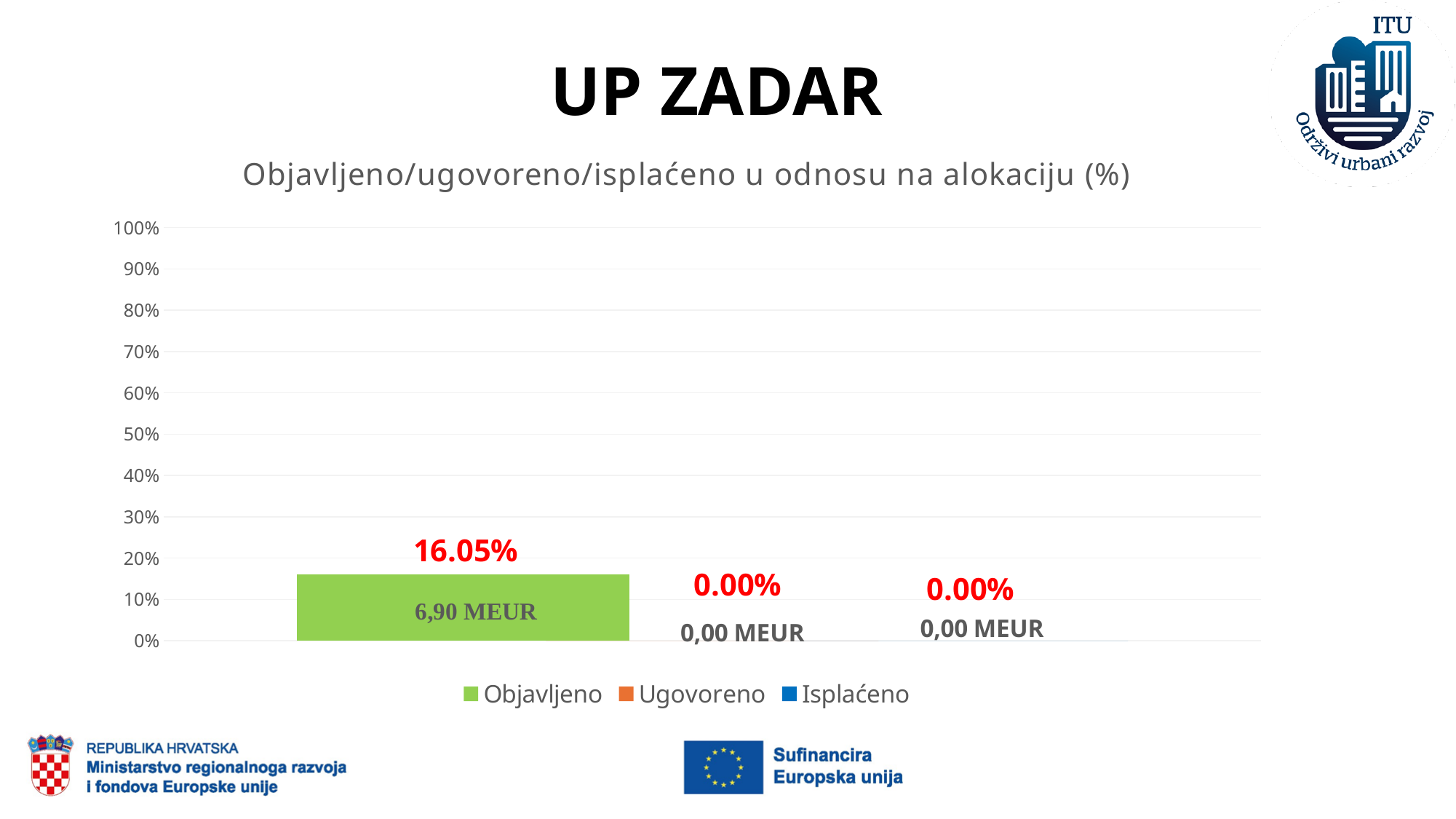
Is the value for Objavljeno greater or less than 20%? less What is the difference between the Objavljeno and Ugovoreno percentages? 16.05% Which series has the highest value? Objavljeno Which is larger, the value for Objavljeno or the value for Isplaćeno? Objavljeno What is the value for Isplaćeno? 0.00% What kind of chart is shown on the slide? bar chart What amount in MEUR is shown for Ugovoreno? 0,00 MEUR What is the value for Ugovoreno? 0.00% What is the title of the chart? Objavljeno/ugovoreno/isplaćeno u odnosu na alokaciju (%) What is the value for Objavljeno? 16.05% How many series does the legend list? 3 What amount in MEUR is shown for Objavljeno? 6,90 MEUR